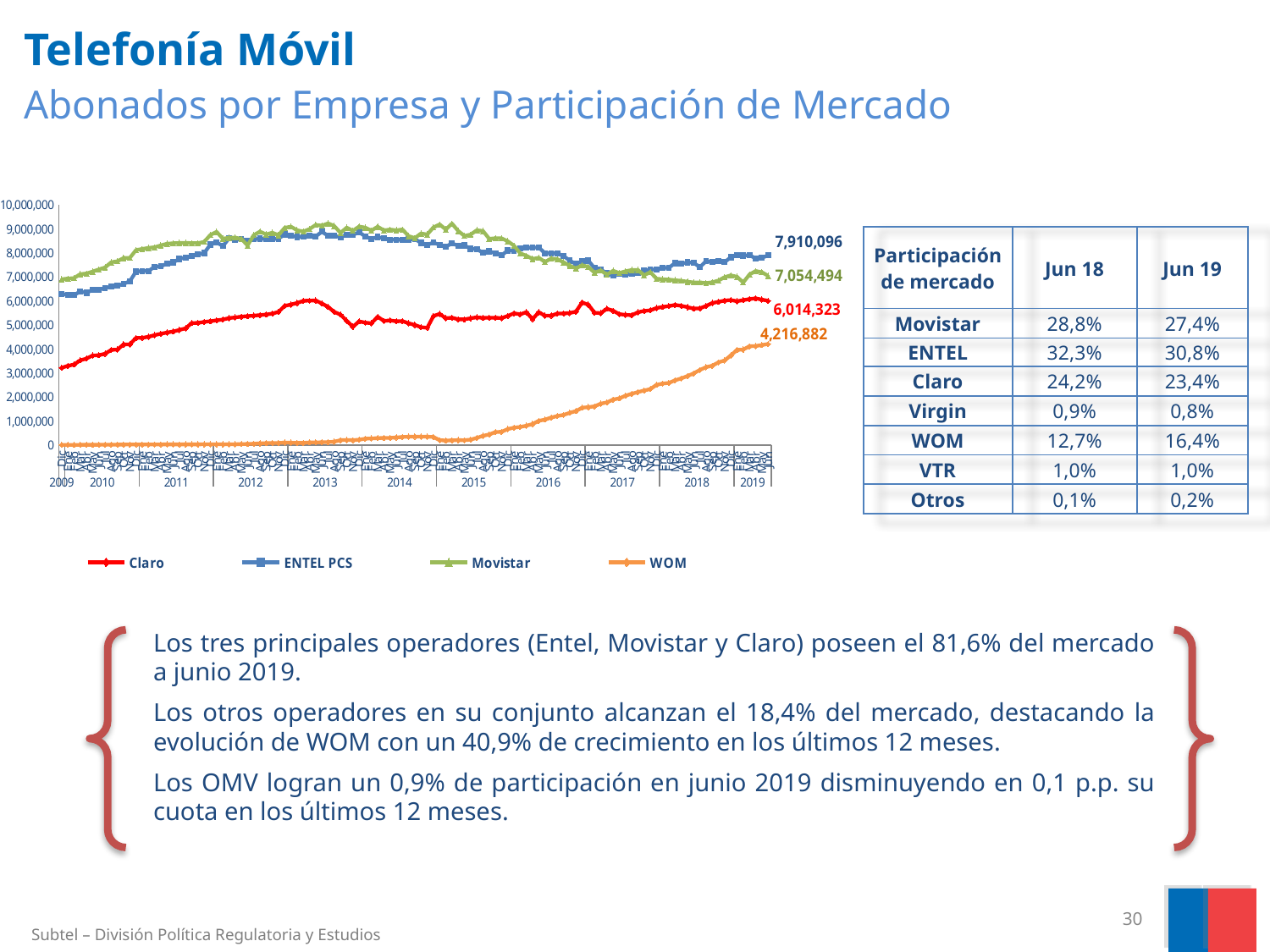
At the end of the line chart, which series has the larger value, Claro or Movistar? Movistar Which series has the lowest value at the end of the line chart (2019)? WOM What is the final labelled value for the Movistar series in the line chart? 7,054,494 What is the final labelled value for the ENTEL PCS series in the line chart? 7,910,096 What is the final labelled value for the Claro series in the line chart? 6,014,323 What is the difference between the final labelled values of Claro and WOM in the line chart? 1,797,441 Is the value for WOM in 2015 greater or less than 1,000,000 in the line chart? less What is the final labelled value for the WOM series in the line chart? 4,216,882 How many series does the legend of the line chart list? 4 What is the difference between the final labelled values of ENTEL PCS and Movistar in the line chart? 855,602 What kind of chart is used to show subscribers by company on this slide? Line chart Which series has the highest value at the end of the line chart (2019)? ENTEL PCS